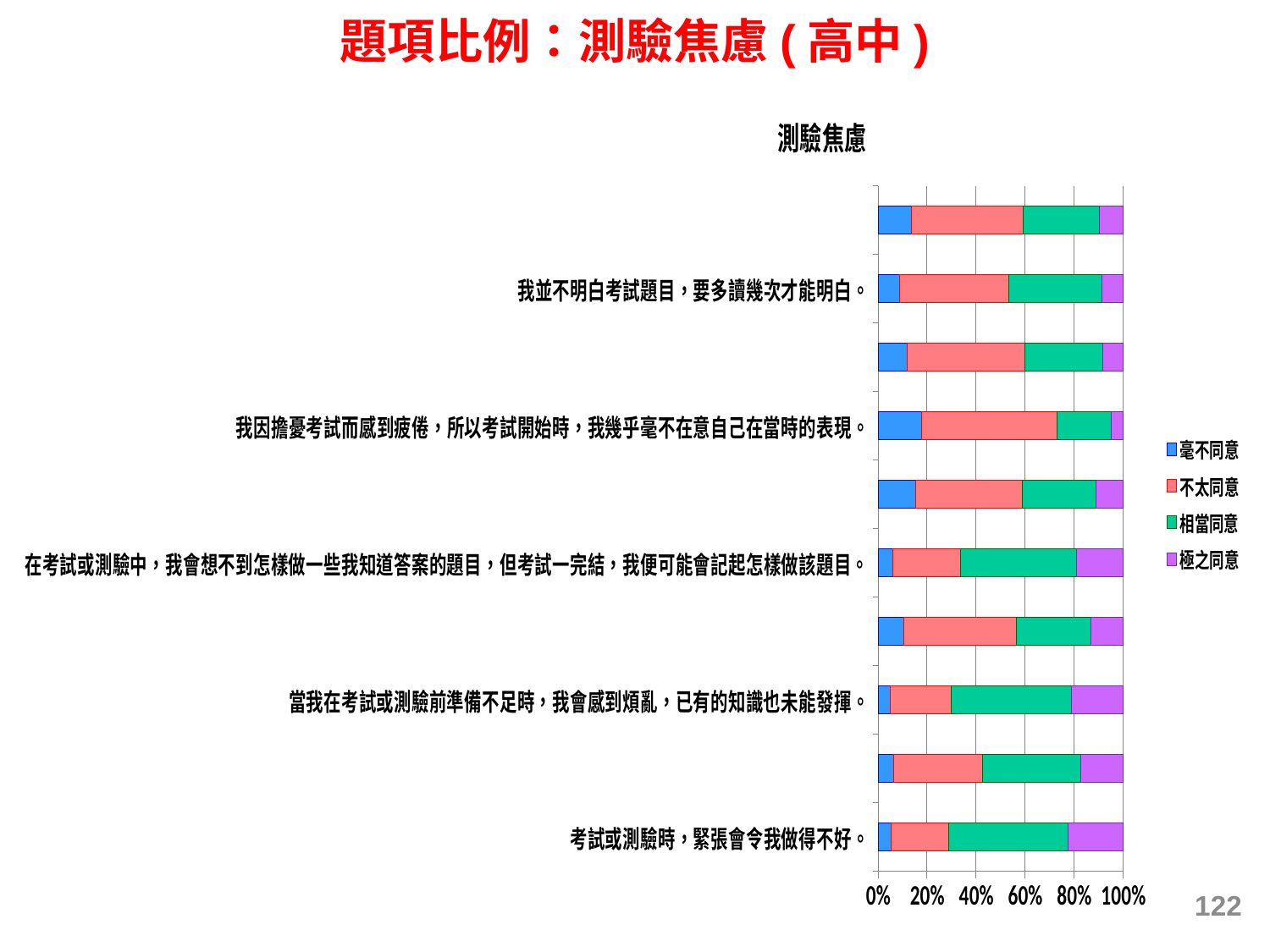
What kind of chart is shown on the slide? Stacked bar chart Which has the larger 極之同意 share: 考試或測驗時，緊張會令我做得不好。 or 我因擔憂考試而感到疲倦，所以考試開始時，我幾乎毫不在意自己在當時的表現。? 考試或測驗時，緊張會令我做得不好。 Is the 毫不同意 share for 我因擔憂考試而感到疲倦，所以考試開始時，我幾乎毫不在意自己在當時的表現。 greater or less than 20%? less How many series does the legend of the 測驗焦慮 chart list? 4 Which legend entry is shown in green? 相當同意 Is the 相當同意 share for 考試或測驗時，緊張會令我做得不好。 greater or less than 40%? greater What is the title of the chart? 測驗焦慮 Is the 極之同意 share for 我並不明白考試題目，要多讀幾次才能明白。 greater or less than 20%? less Which has the larger 毫不同意 share: 我因擔憂考試而感到疲倦，所以考試開始時，我幾乎毫不在意自己在當時的表現。 or 考試或測驗時，緊張會令我做得不好。? 我因擔憂考試而感到疲倦，所以考試開始時，我幾乎毫不在意自己在當時的表現。 Which has the larger 不太同意 share: 我並不明白考試題目，要多讀幾次才能明白。 or 當我在考試或測驗前準備不足時，我會感到煩亂，已有的知識也未能發揮。? 我並不明白考試題目，要多讀幾次才能明白。 How many bars are plotted in the 測驗焦慮 chart? 10